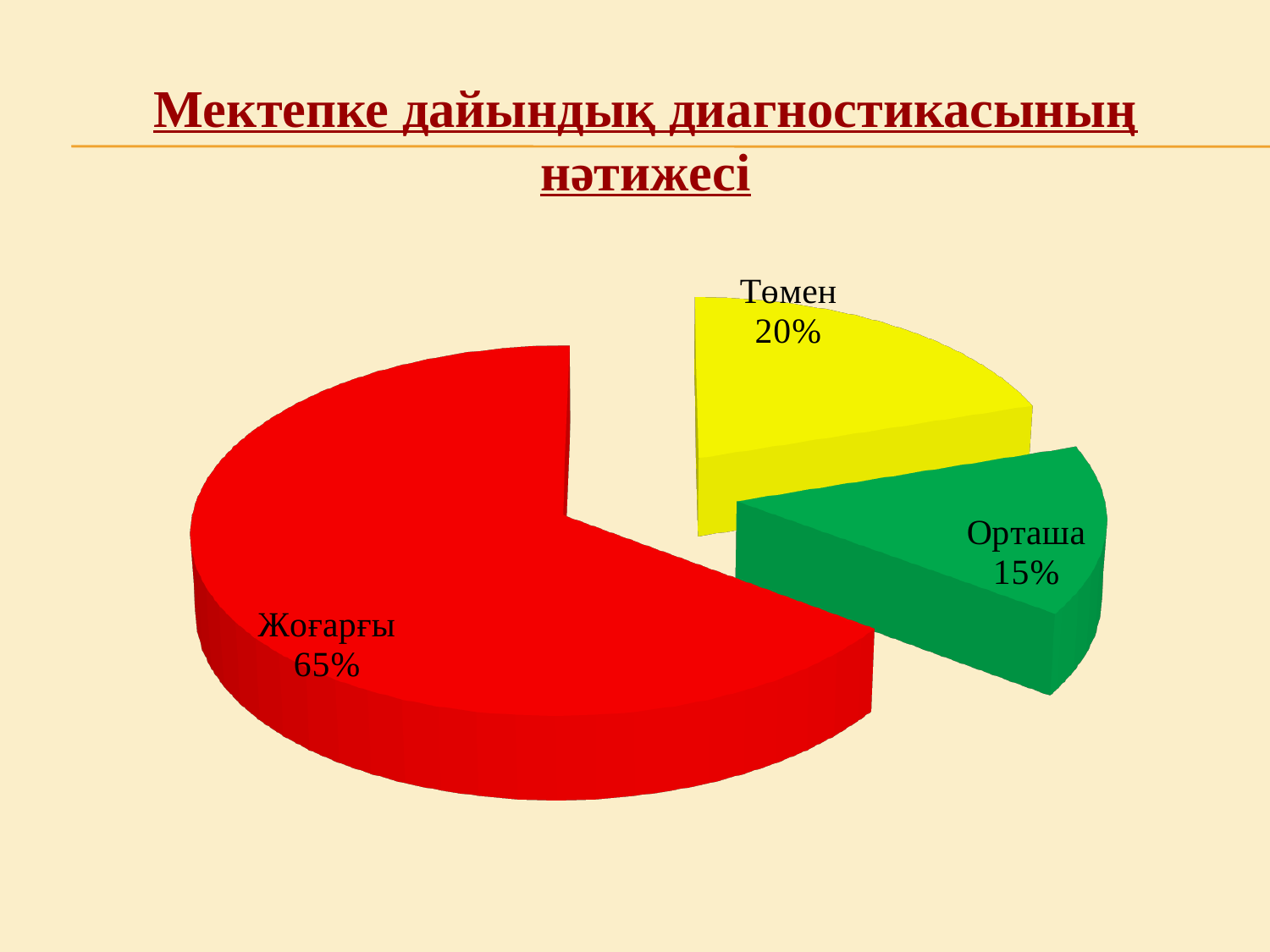
Which category has the smallest share of the pie? Орташа What colour is the Жоғарғы slice? red Which category has the largest share of the pie? Жоғарғы Which is larger, the value for Төмен or the value for Орташа? Төмен What kind of chart is shown on the slide? pie chart What is the difference between the values for Төмен and Орташа? 5% What is the value for Орташа? 15% What is the value for Жоғарғы? 65% What is the difference between the values for Жоғарғы and Төмен? 45% What is the title of the chart? Мектепке дайындық диагностикасының нәтижесі How many slices does the pie chart have? 3 What is the value for Төмен? 20%